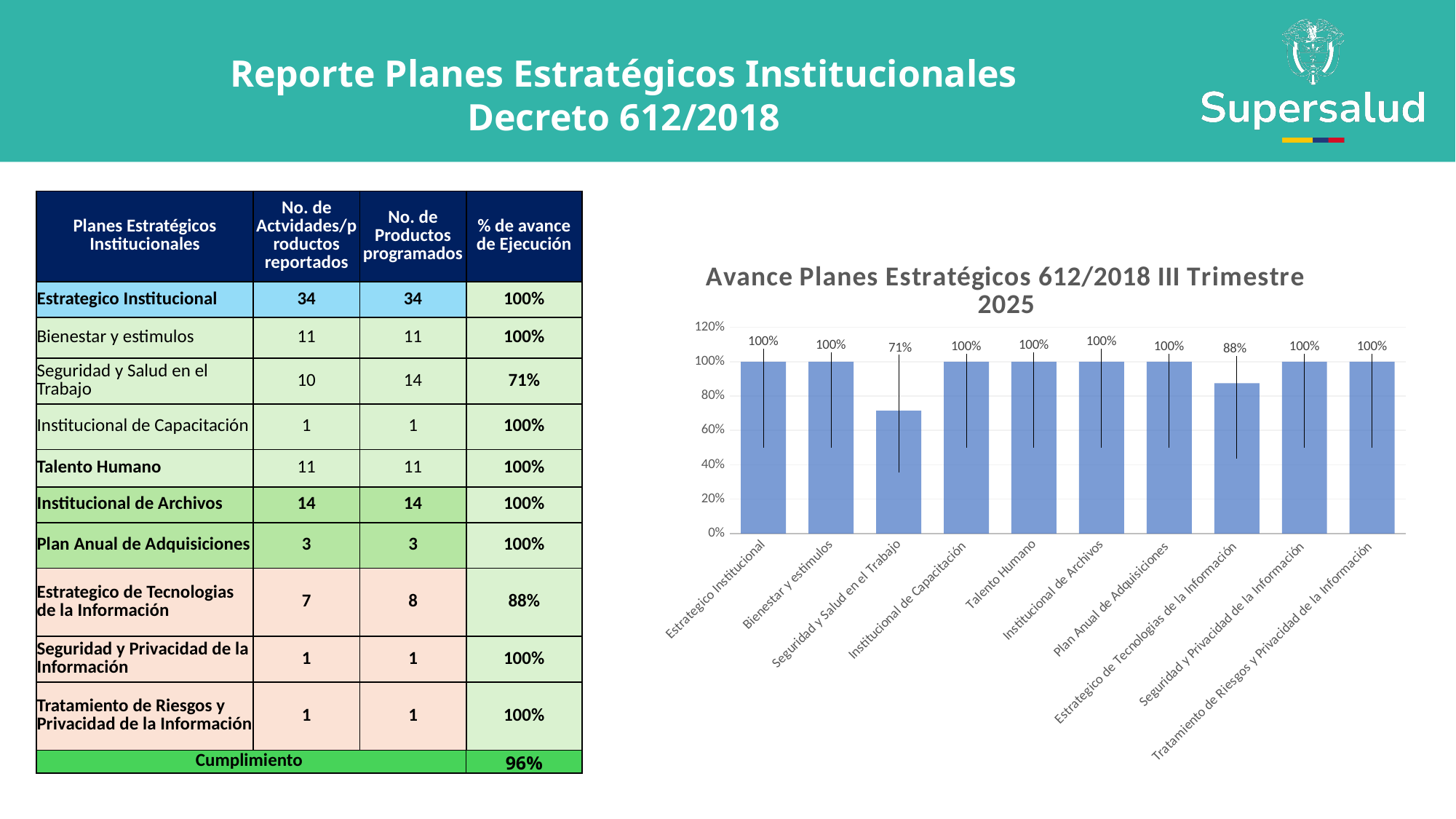
Which is larger, the value for Estrategico de Tecnologias de la Información or the value for Seguridad y Salud en el Trabajo? Estrategico de Tecnologias de la Información What is the title of the chart? Avance Planes Estratégicos 612/2018 III Trimestre 2025 What is the value for Estrategico de Tecnologias de la Información in the chart? 88% What is the value for Talento Humano in the chart? 100% How many categories in the chart have a value of 100%? 8 Which category has the lowest value in the chart? Seguridad y Salud en el Trabajo What is the value for Seguridad y Salud en el Trabajo in the chart? 71% What is the difference between the values for Estrategico Institucional and Seguridad y Salud en el Trabajo? 29% Is the value for Seguridad y Salud en el Trabajo greater or less than 80%? less What kind of chart is shown on the slide? bar chart What is the difference between the values for Estrategico de Tecnologias de la Información and Seguridad y Salud en el Trabajo? 17% How many categories are shown in the chart? 10